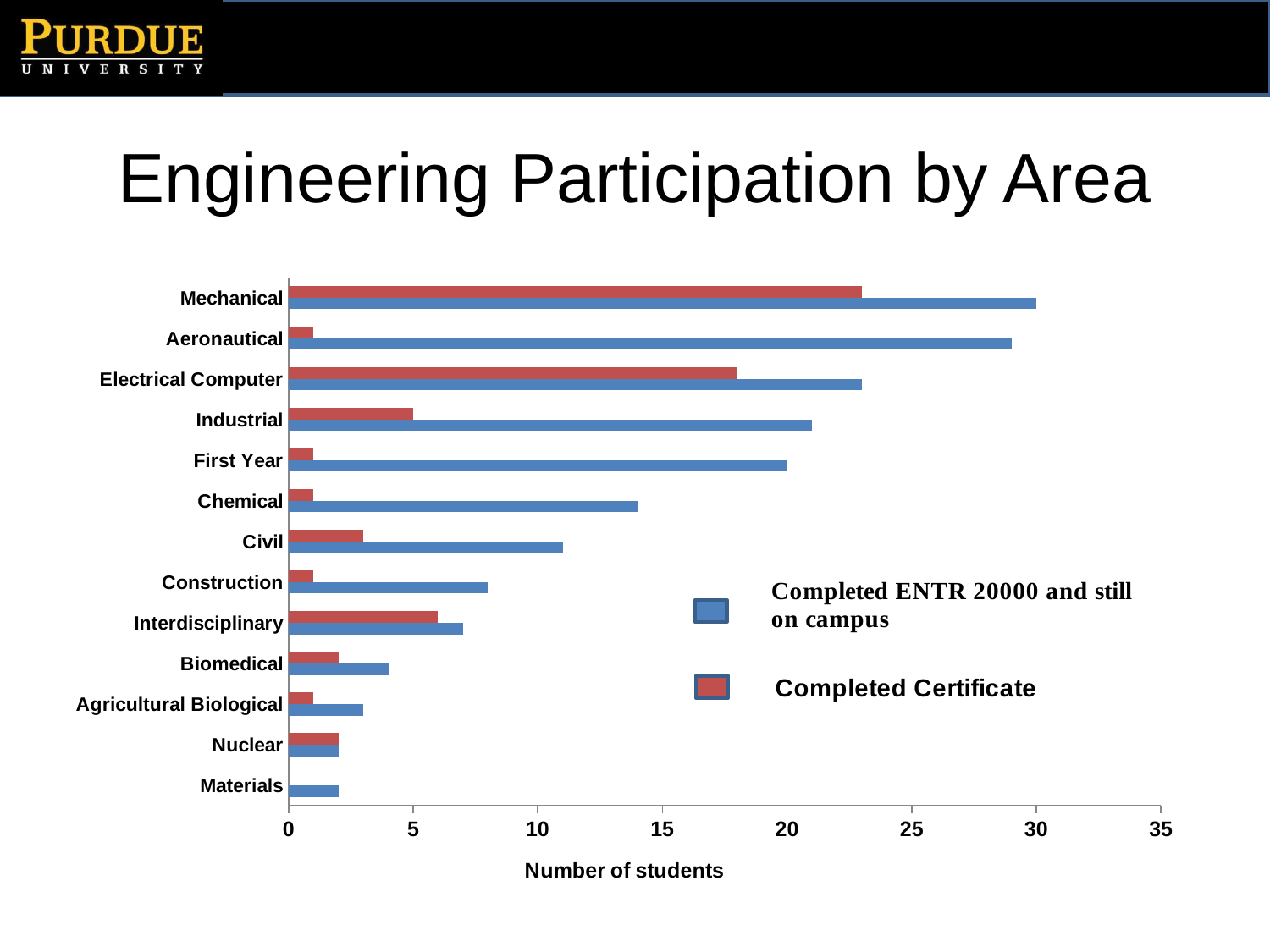
Which area has the lowest value for 'Completed Certificate'? Materials Which area has the highest value for 'Completed Certificate'? Mechanical Which is larger for Industrial: 'Completed ENTR 20000 and still on campus' or 'Completed Certificate'? Completed ENTR 20000 and still on campus How many engineering areas are listed on the chart? 13 Is the 'Completed Certificate' value for Electrical Computer greater or less than 15? greater Is the 'Completed ENTR 20000 and still on campus' value for Aeronautical greater or less than 25? greater What colour represents 'Completed Certificate' in the legend? red How many series does the legend list? 2 What is the label of the horizontal axis? Number of students Is the 'Completed ENTR 20000 and still on campus' value for Chemical greater or less than 15? less What kind of chart is shown on the slide? bar chart Which area has the highest value for 'Completed ENTR 20000 and still on campus'? Mechanical